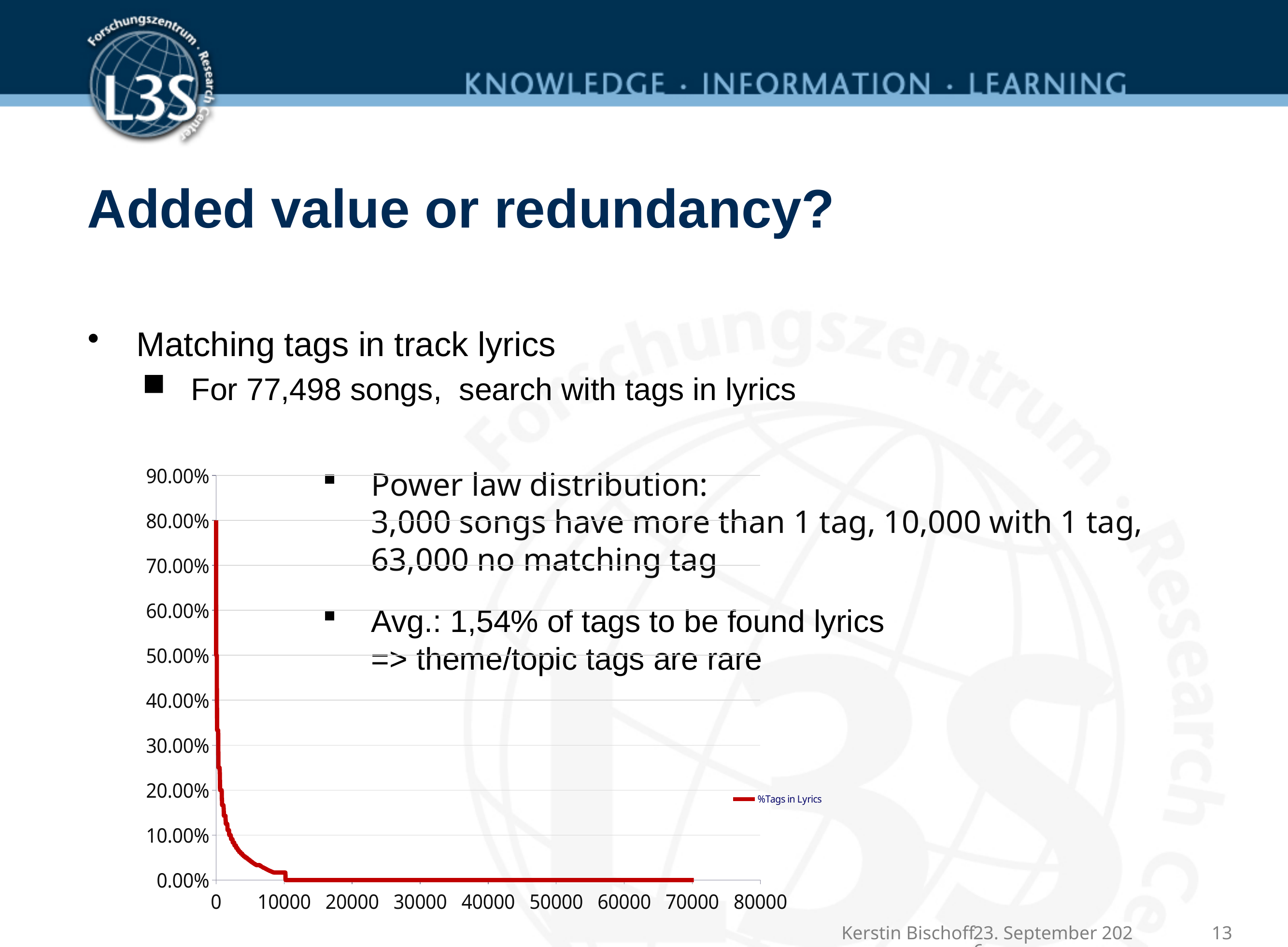
What is the name of the series shown in the chart legend? %Tags in Lyrics How many series does the chart legend list? 1 Is the value of %Tags in Lyrics at x = 20000 greater or less than 10.00%? less Is the value of %Tags in Lyrics at x = 5000 greater or less than 30.00%? less What kind of chart is shown on the slide? line chart Is the value of %Tags in Lyrics at x = 60000 greater or less than 20.00%? less What is the highest value shown on the y axis of the chart? 90.00% Do the values of %Tags in Lyrics rise or fall as the x axis increases? fall